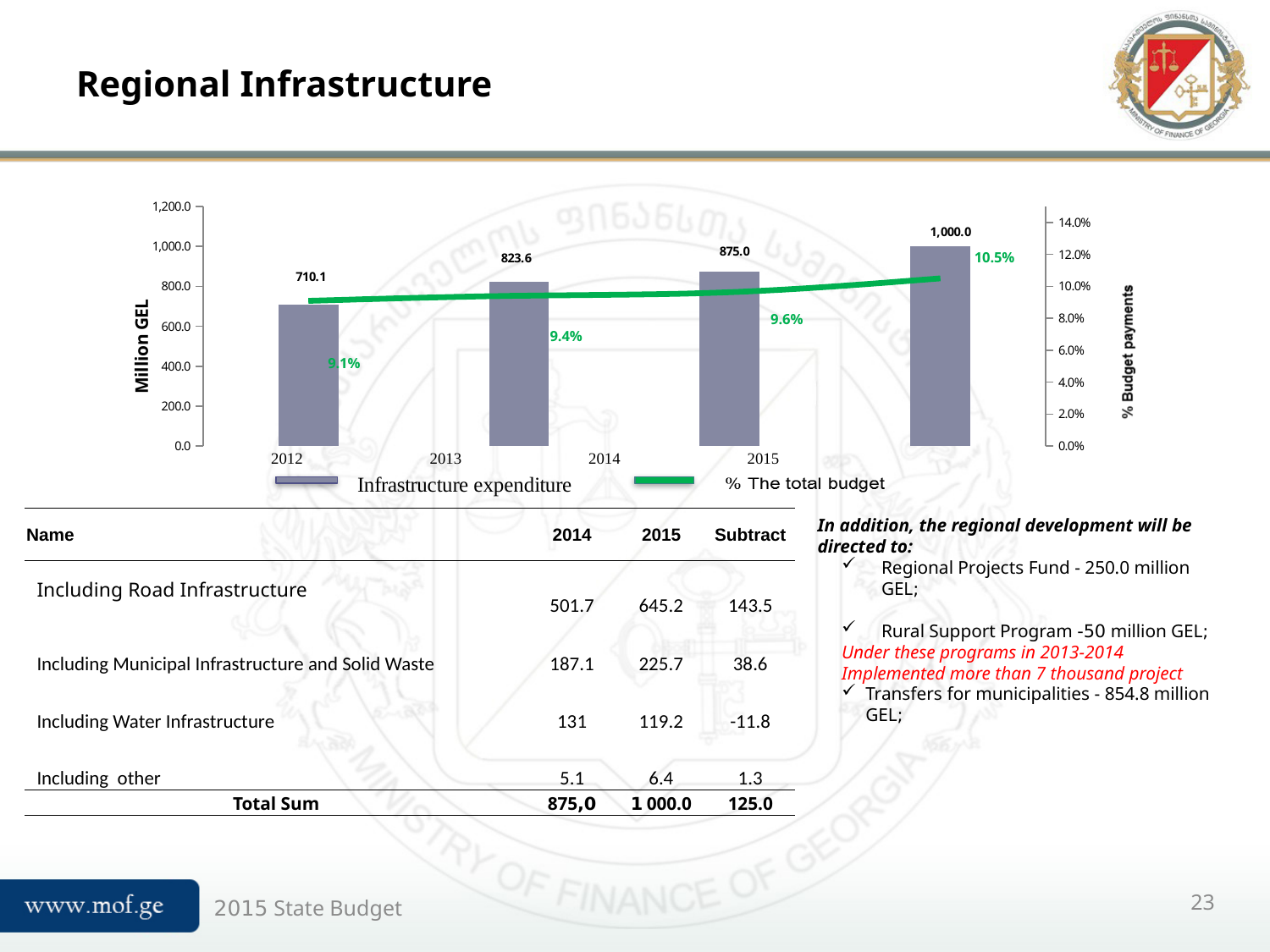
What percentage of the total budget is shown for 2015? 10.5% Which year has the lowest share of the total budget? 2012 What is the infrastructure expenditure value shown for 2015? 1,000.0 What is the label of the left vertical axis of the chart? Million GEL Which year has the larger infrastructure expenditure, 2013 or 2014? 2014 What percentage of the total budget is shown for 2013? 9.4% How many years are shown on the x axis of the chart? 4 What is the difference in infrastructure expenditure between 2015 and 2014? 125.0 Does infrastructure expenditure rise or fall from 2012 to 2015? rise How many series does the chart legend list? 2 Which year has the highest infrastructure expenditure? 2015 What is the infrastructure expenditure value shown for 2012? 710.1